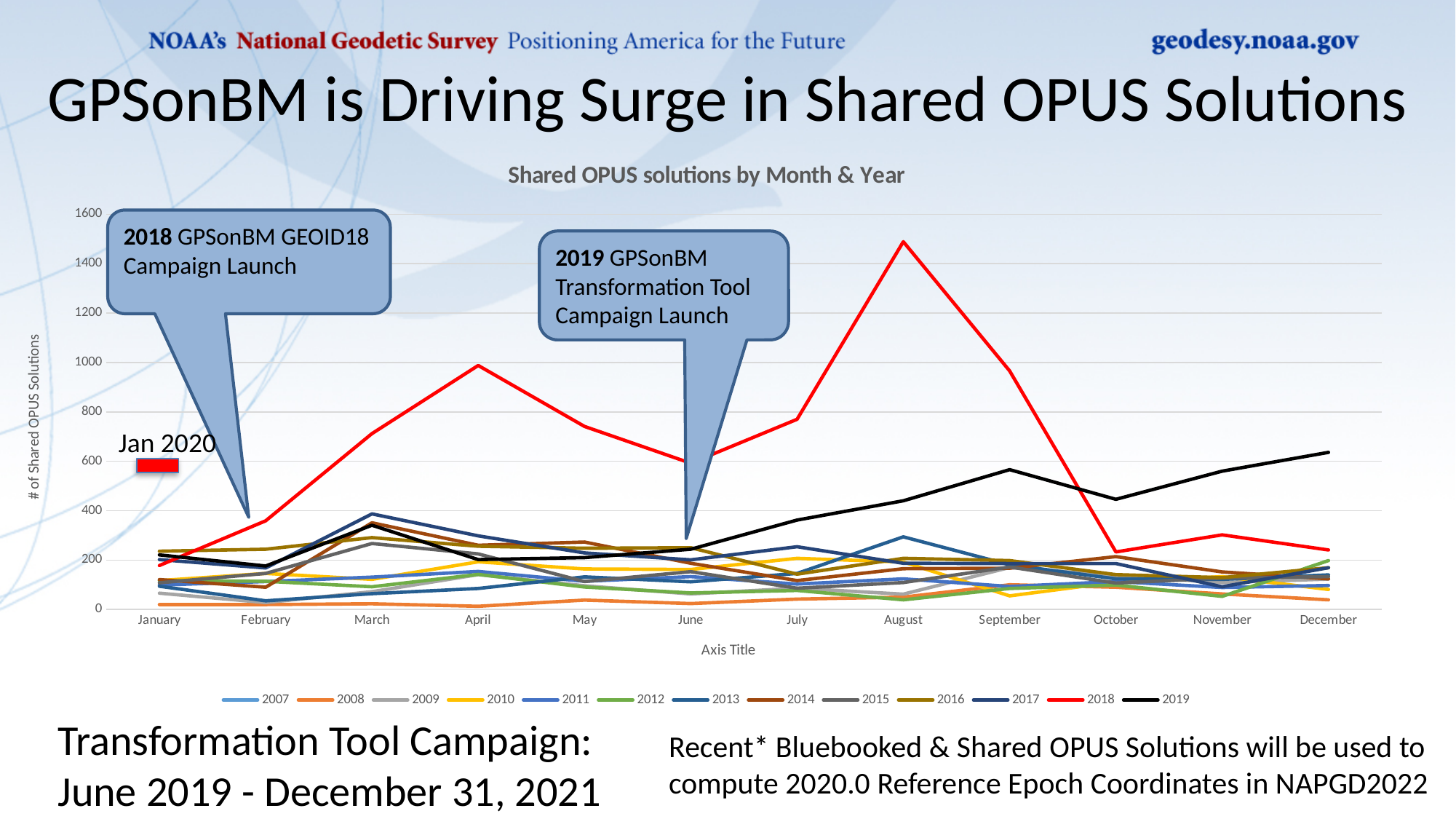
How many series does the legend list? 13 Is the value for 2019 in December greater or less than 600? greater What kind of chart is shown on the slide? Line chart In which month does the 2019 series reach its highest value? December In which month does the 2018 series reach its highest value? August Does the 2018 series rise or fall from August to October? Fall What is the title of the chart? Shared OPUS solutions by Month & Year Which series has the larger value in December, 2018 or 2019? 2019 Is the value for 2018 in October greater or less than 400? less Is the value for 2018 in August greater or less than 1400? greater How many months are shown along the x axis? 12